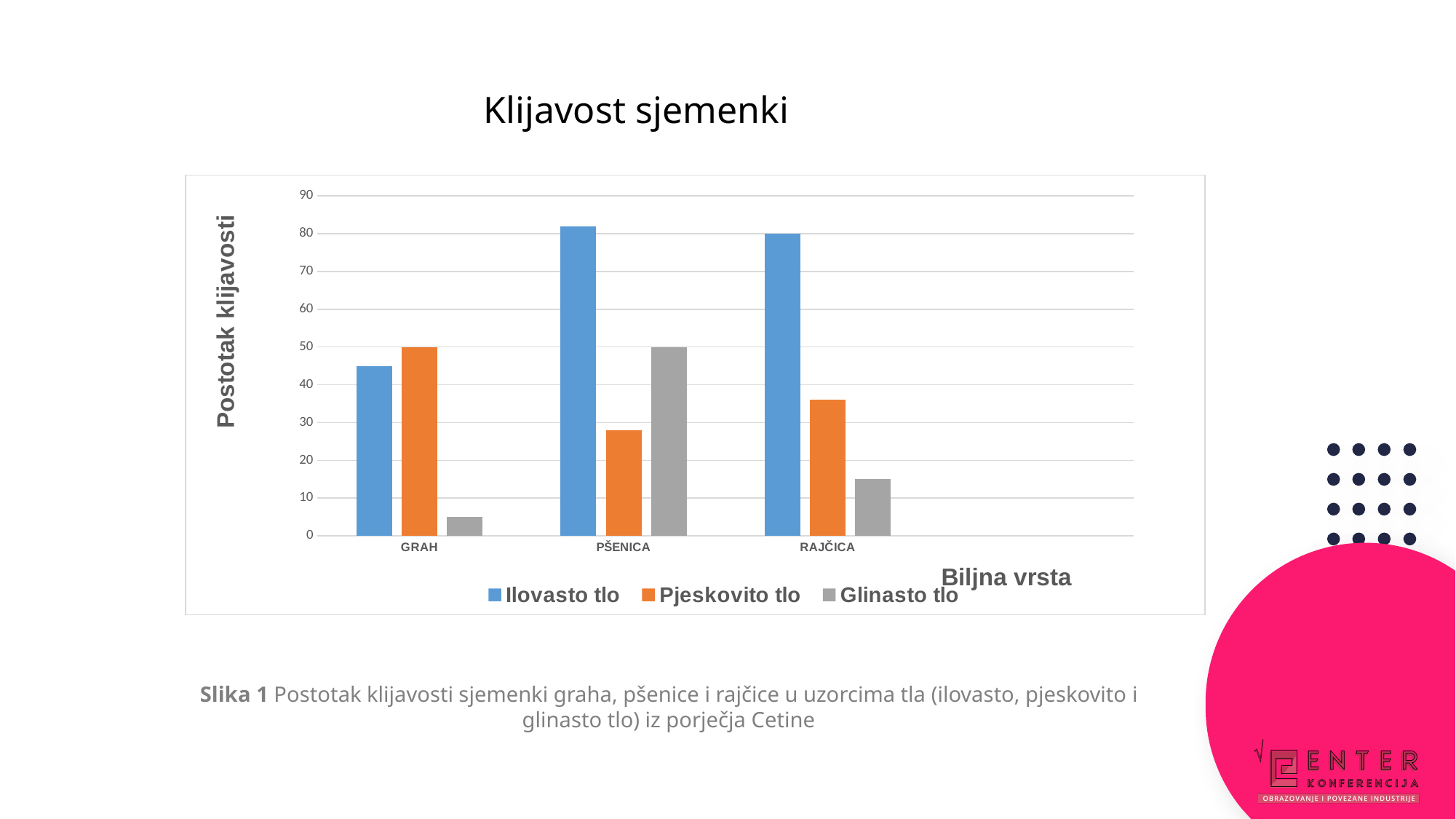
Which soil type has the lowest value for RAJČICA? Glinasto tlo What is the value for Glinasto tlo for PŠENICA? 50 What is the value for Pjeskovito tlo for GRAH? 50 What is the label of the vertical axis? Postotak klijavosti Which is larger for PŠENICA: Ilovasto tlo or Pjeskovito tlo? Ilovasto tlo Is the value for Glinasto tlo for GRAH greater or less than 10? less What is the value for Ilovasto tlo for RAJČICA? 80 What is the title of the chart? Klijavost sjemenki What kind of chart is shown on the slide? bar chart Is the value for Pjeskovito tlo for PŠENICA greater or less than 30? less How many series does the legend list? 3 How many plant species (categories) are shown on the x axis? 3